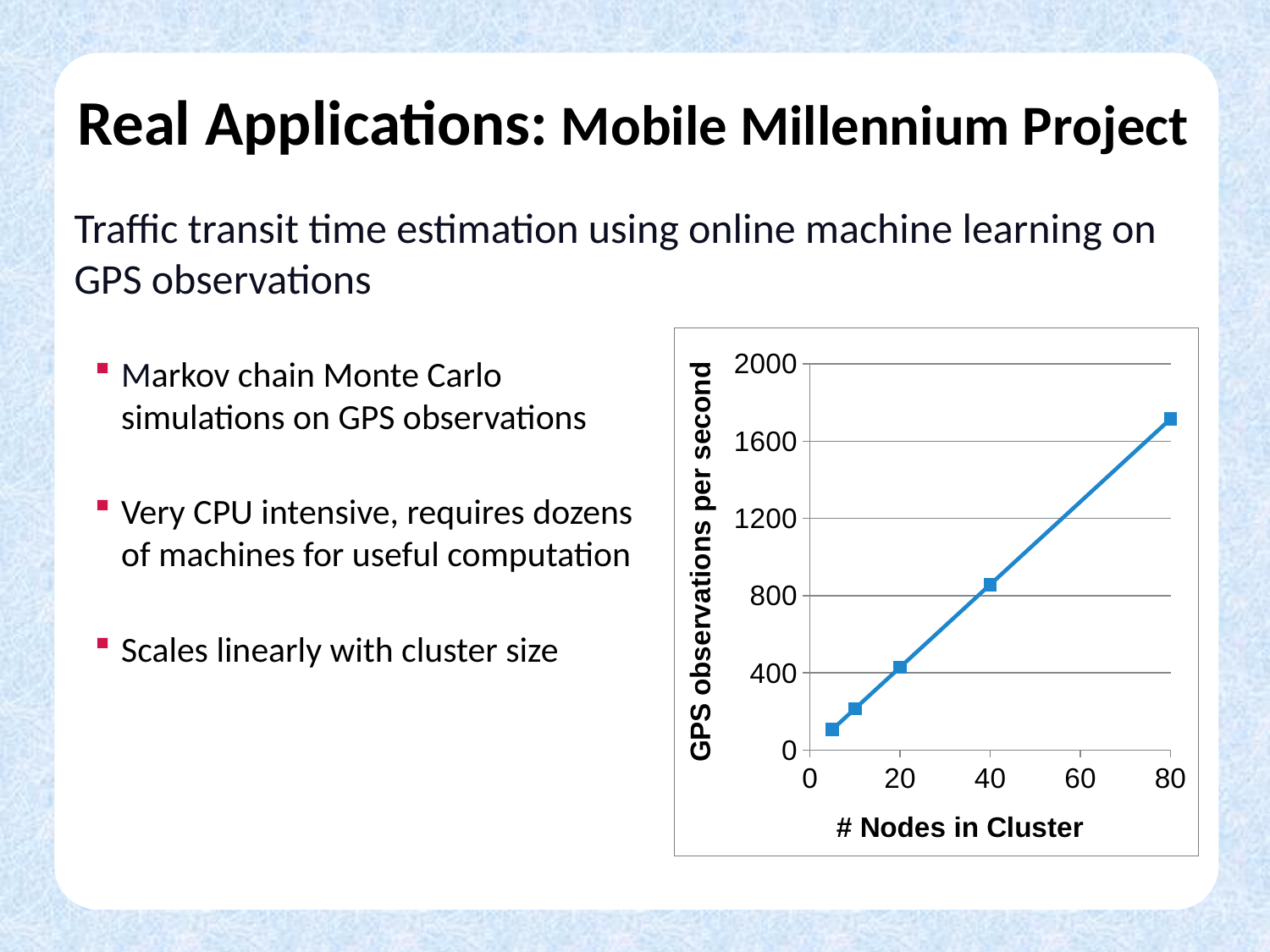
At which number of nodes in the cluster is the GPS observations per second highest? 80 Is the value for 40 nodes in the cluster greater or less than 1200 GPS observations per second? less Which has more GPS observations per second: 40 nodes or 20 nodes in the cluster? 40 nodes Is the value for 80 nodes in the cluster greater or less than 1600 GPS observations per second? greater How many data points are plotted on the chart? 5 What kind of chart is shown on the slide? line chart What is the label of the x axis of the chart? # Nodes in Cluster What is the label of the y axis of the chart? GPS observations per second Is the value for 10 nodes in the cluster greater or less than 400 GPS observations per second? less Do GPS observations per second rise or fall as the number of nodes in the cluster increases? rise